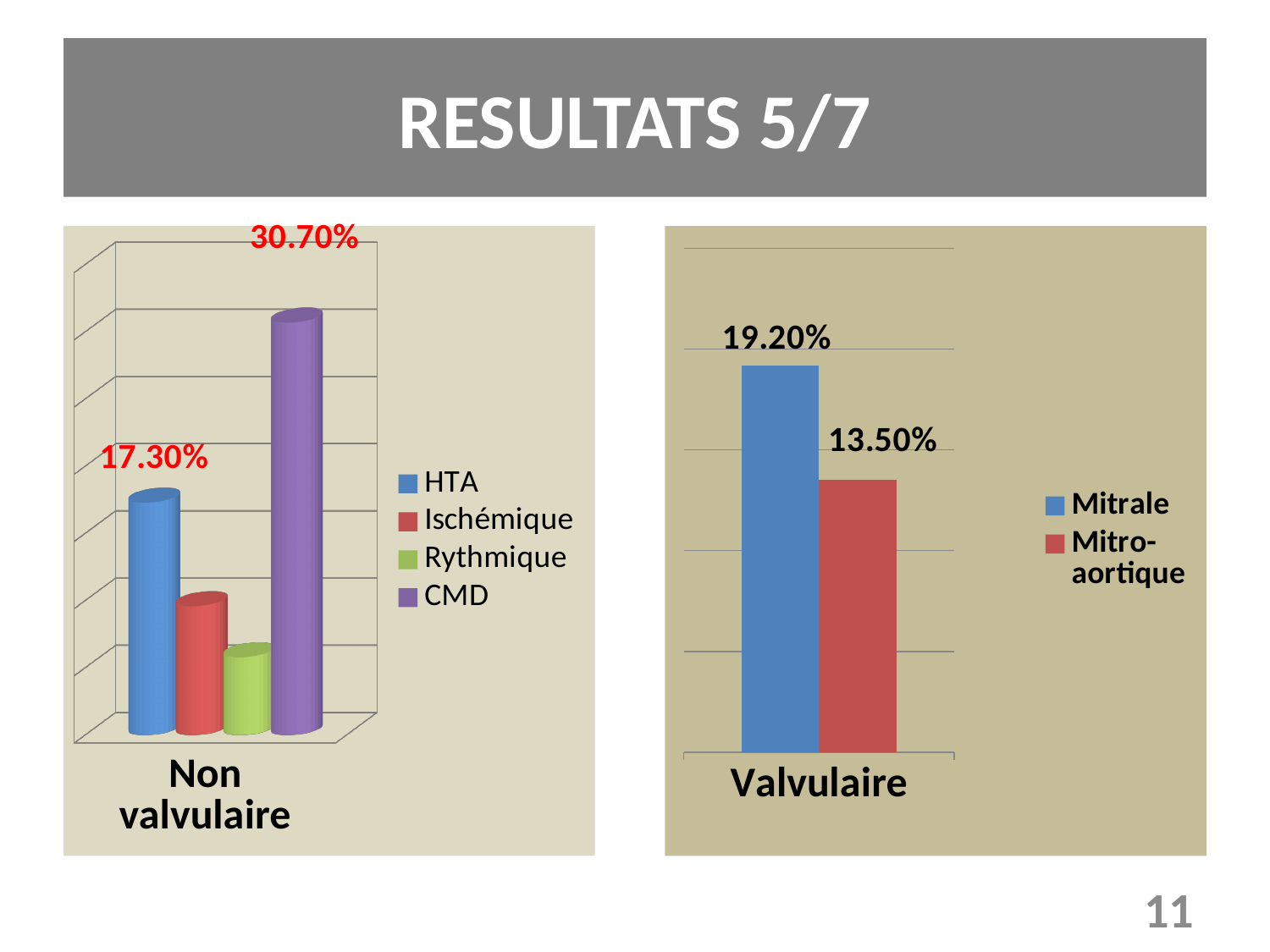
In the right chart (Valvulaire), what is the difference between the Mitrale value and the Mitro-aortique value? 5.70% In the left chart (Non valvulaire), which is larger, Ischémique or Rythmique? Ischémique In the left chart (Non valvulaire), what is the value for HTA? 17.30% In the right chart (Valvulaire), how many series does the legend list? 2 In the left chart (Non valvulaire), what is the value for CMD? 30.70% What kind of chart is the right chart (Valvulaire)? Bar chart In the right chart (Valvulaire), what is the value for Mitrale? 19.20% In the left chart (Non valvulaire), how many series does the legend list? 4 In the left chart (Non valvulaire), what is the difference between the CMD value and the HTA value? 13.40% In the right chart (Valvulaire), what is the value for Mitro-aortique? 13.50% In the left chart (Non valvulaire), which series has the lowest value? Rythmique In the left chart (Non valvulaire), which series has the highest value? CMD